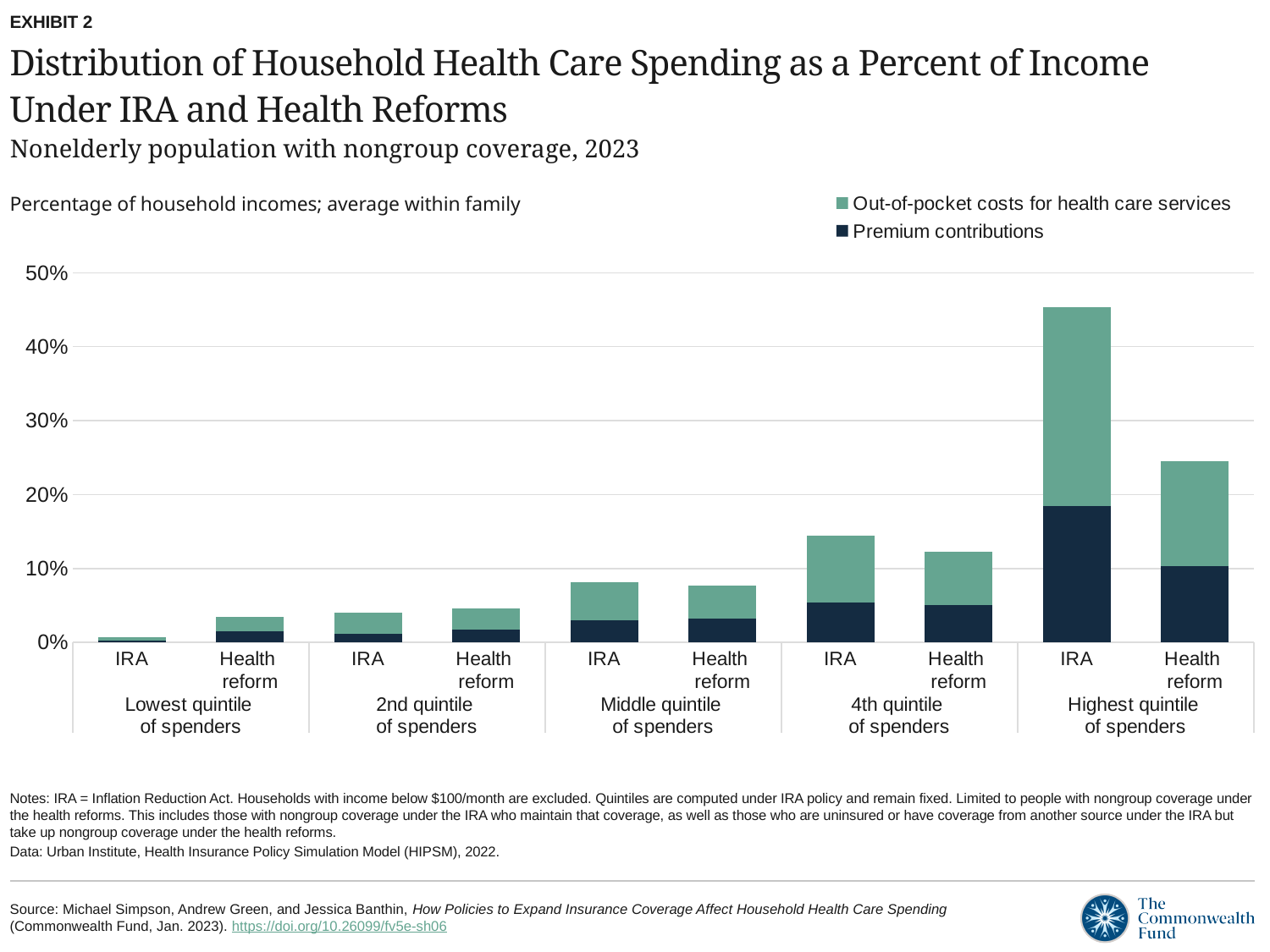
Is the total value for IRA in the 4th quintile of spenders greater or less than 10%? greater What kind of chart is shown on the slide? Stacked bar chart Which series is shown in the dark navy colour in the legend? Premium contributions Which bar has the highest total household health care spending as a percent of income? IRA, Highest quintile of spenders How many series does the legend list? 2 In the 4th quintile of spenders, which bar is taller in total: IRA or Health reform? IRA Which bar has the lowest total household health care spending as a percent of income? IRA, Lowest quintile of spenders Is the total value for IRA in the Highest quintile of spenders greater or less than 40%? greater Is the total value for Health reform in the Highest quintile of spenders greater or less than 30%? less Do the IRA bar totals rise or fall moving from the Lowest quintile to the Highest quintile of spenders? Rise How many bars are plotted in the chart? 10 In the Lowest quintile of spenders, which bar is taller in total: IRA or Health reform? Health reform